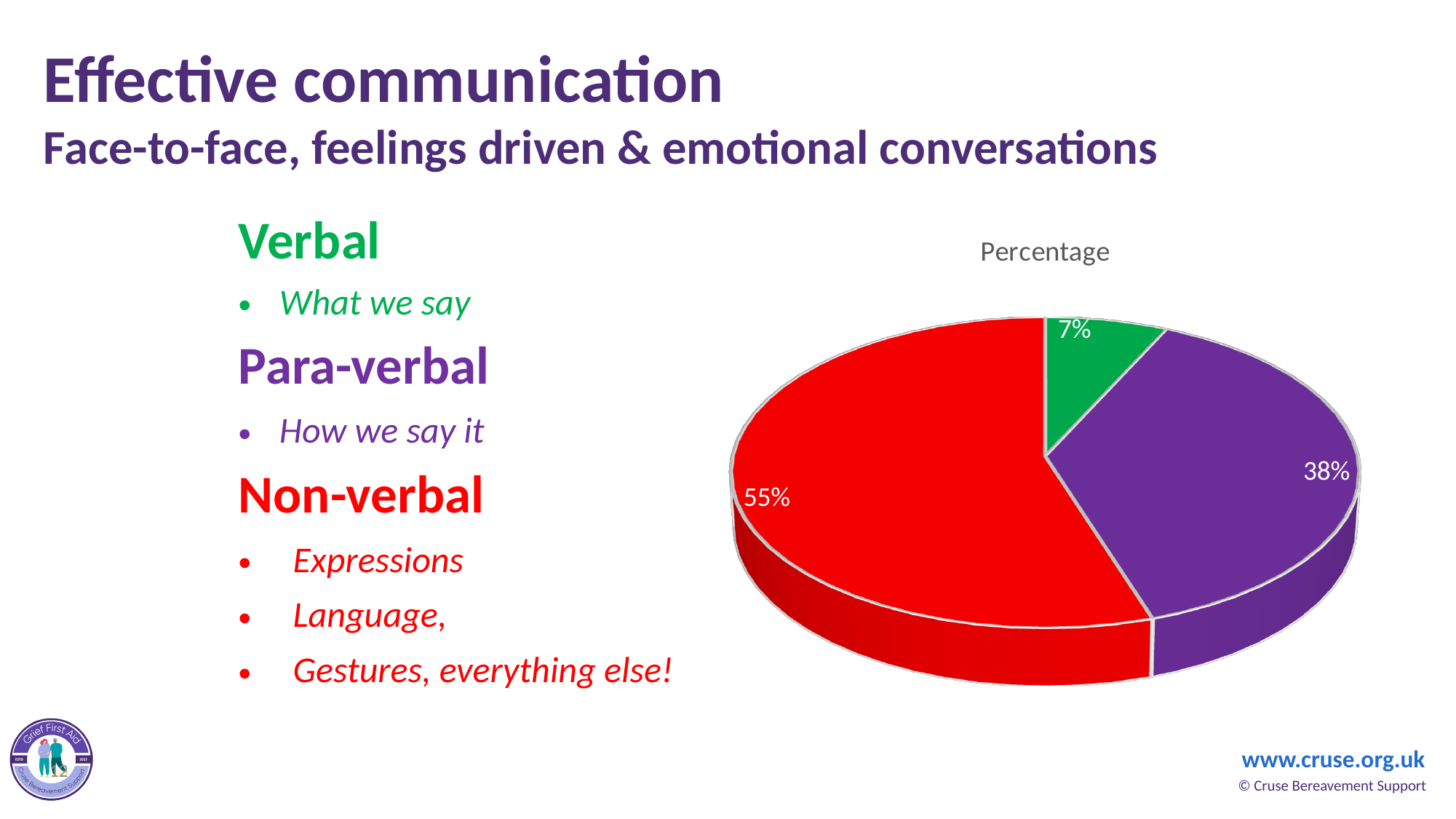
Which colour slice is the largest in the pie chart? red What colour is the slice labelled 55% in the pie chart? red Which is larger in the pie chart, the purple slice or the green slice? purple How many slices does the pie chart have? 3 What is the title of the chart? Percentage What is the difference between the purple slice and the green slice in the pie chart? 31% Which colour slice is the smallest in the pie chart? green What percentage is shown on the purple slice of the pie chart? 38% What percentage is shown on the green slice of the pie chart? 7% What is the difference between the red slice and the purple slice in the pie chart? 17% What kind of chart is shown on the slide? pie chart What percentage is shown on the red slice of the pie chart? 55%